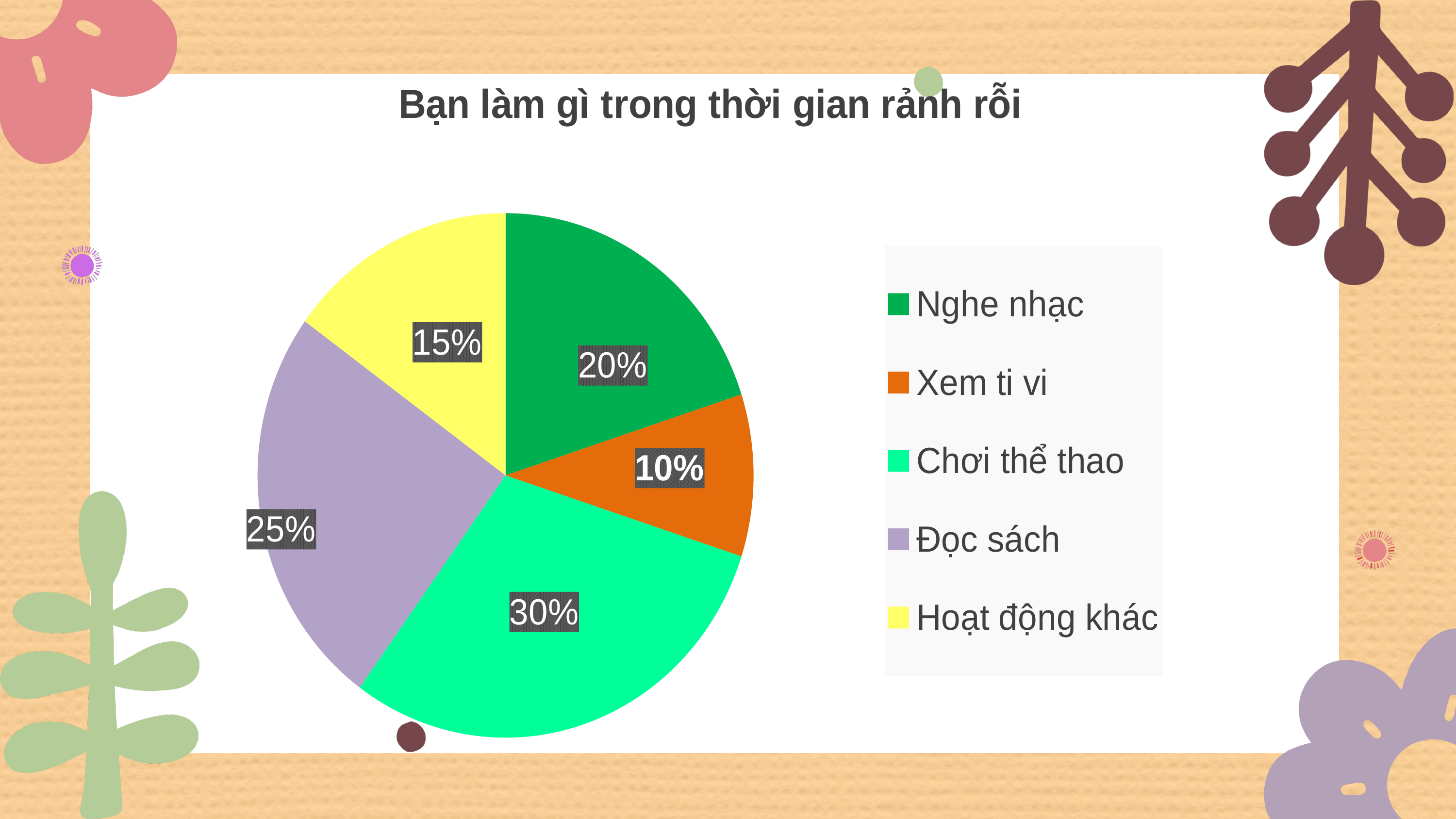
What percentage is shown for Xem ti vi? 10% How many categories does the pie chart have? 5 Which activity has the largest share of the pie? Chơi thể thao Which activity has the smallest share of the pie? Xem ti vi Which is larger, the share for Đọc sách or the share for Hoạt động khác? Đọc sách What percentage is shown for Đọc sách? 25% What kind of chart is shown on the slide? pie chart What percentage is shown for Nghe nhạc? 20% What percentage is shown for Chơi thể thao? 30% What is the title of the chart? Bạn làm gì trong thời gian rảnh rỗi What is the difference between the shares for Chơi thể thao and Nghe nhạc? 10% What percentage is shown for Hoạt động khác? 15%